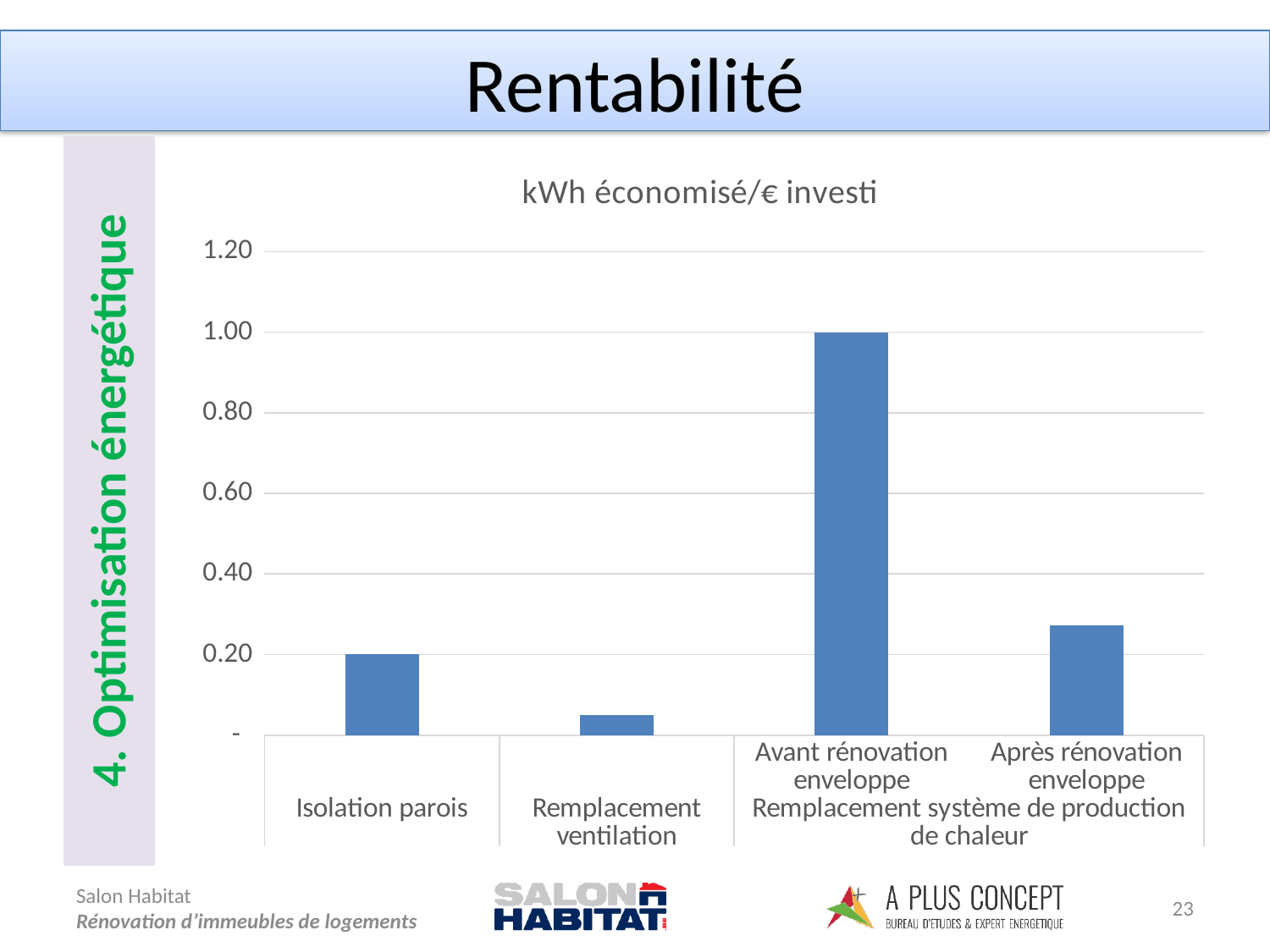
Which is larger, the value for Isolation parois or the value for Après rénovation enveloppe? Après rénovation enveloppe Which is larger, the value for Avant rénovation enveloppe or the value for Après rénovation enveloppe? Avant rénovation enveloppe What type of chart is shown on the slide? bar chart Which category has the highest value? Avant rénovation enveloppe Is the value for Remplacement ventilation greater or less than 0.20? less What is the title of the chart? kWh économisé/€ investi How many bars are plotted in the chart? 4 Is the value for Après rénovation enveloppe greater or less than 0.20? greater Which category has the lowest value? Remplacement ventilation